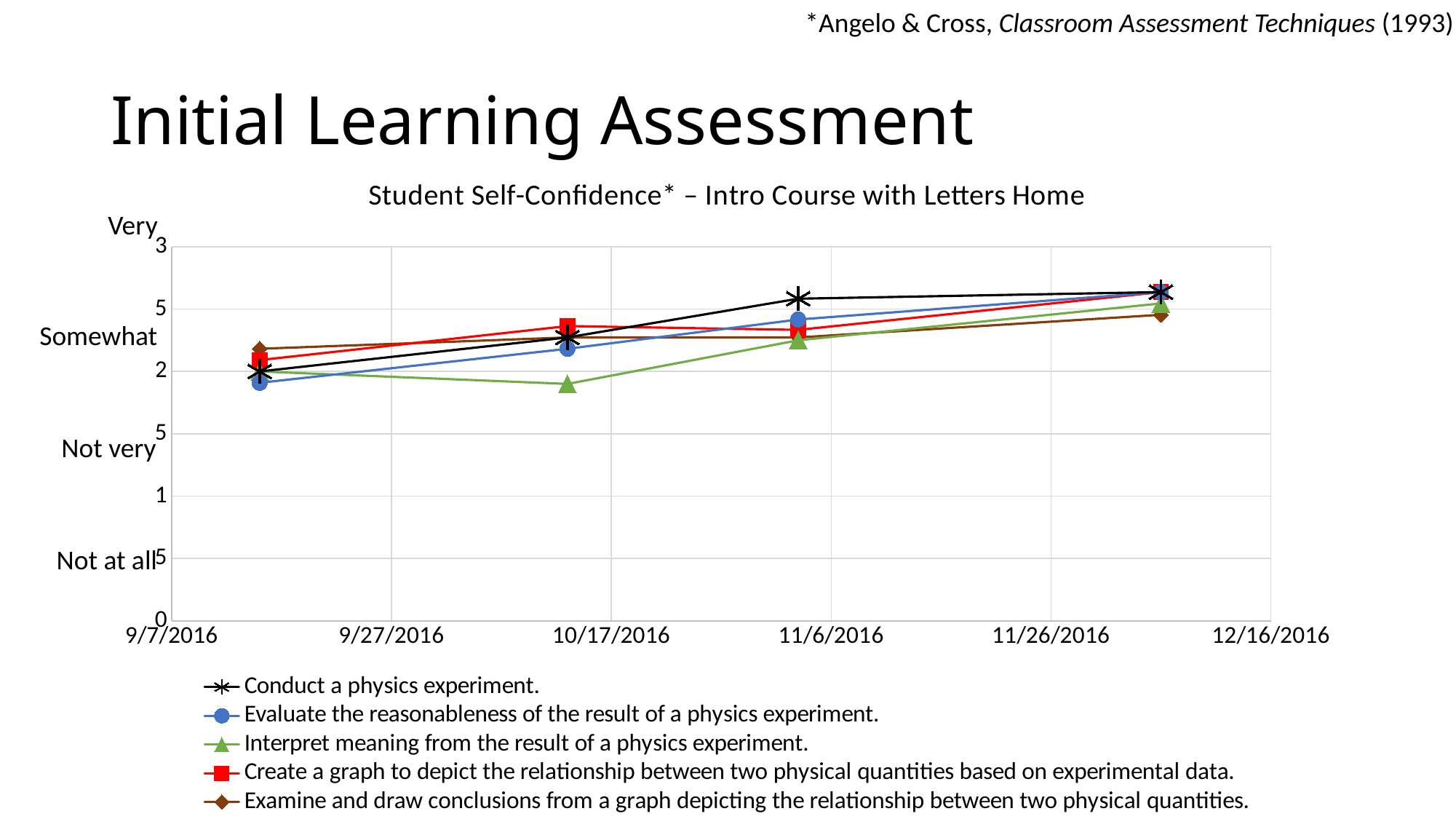
Which series has the highest value at the third point (from the left)? Conduct a physics experiment. Is the value of the first point of 'Evaluate the reasonableness of the result of a physics experiment.' greater or less than 2? less Does the 'Conduct a physics experiment.' series rise or fall from its first point to its last point? rise Is the value of the third point (from the left) of 'Conduct a physics experiment.' greater or less than 2.5? greater Is the value of the second point (from the left) of 'Interpret meaning from the result of a physics experiment.' greater or less than 2? less At the first point, which is higher: 'Examine and draw conclusions from a graph depicting the relationship between two physical quantities.' or 'Evaluate the reasonableness of the result of a physics experiment.'? Examine and draw conclusions from a graph depicting the relationship between two physical quantities. How many data points does the 'Conduct a physics experiment.' series have? 4 How many series does the legend list? 5 What is the title of the chart? Student Self-Confidence* – Intro Course with Letters Home Which series has the lowest value at the second point (from the left)? Interpret meaning from the result of a physics experiment. What kind of chart is shown on the slide? line chart